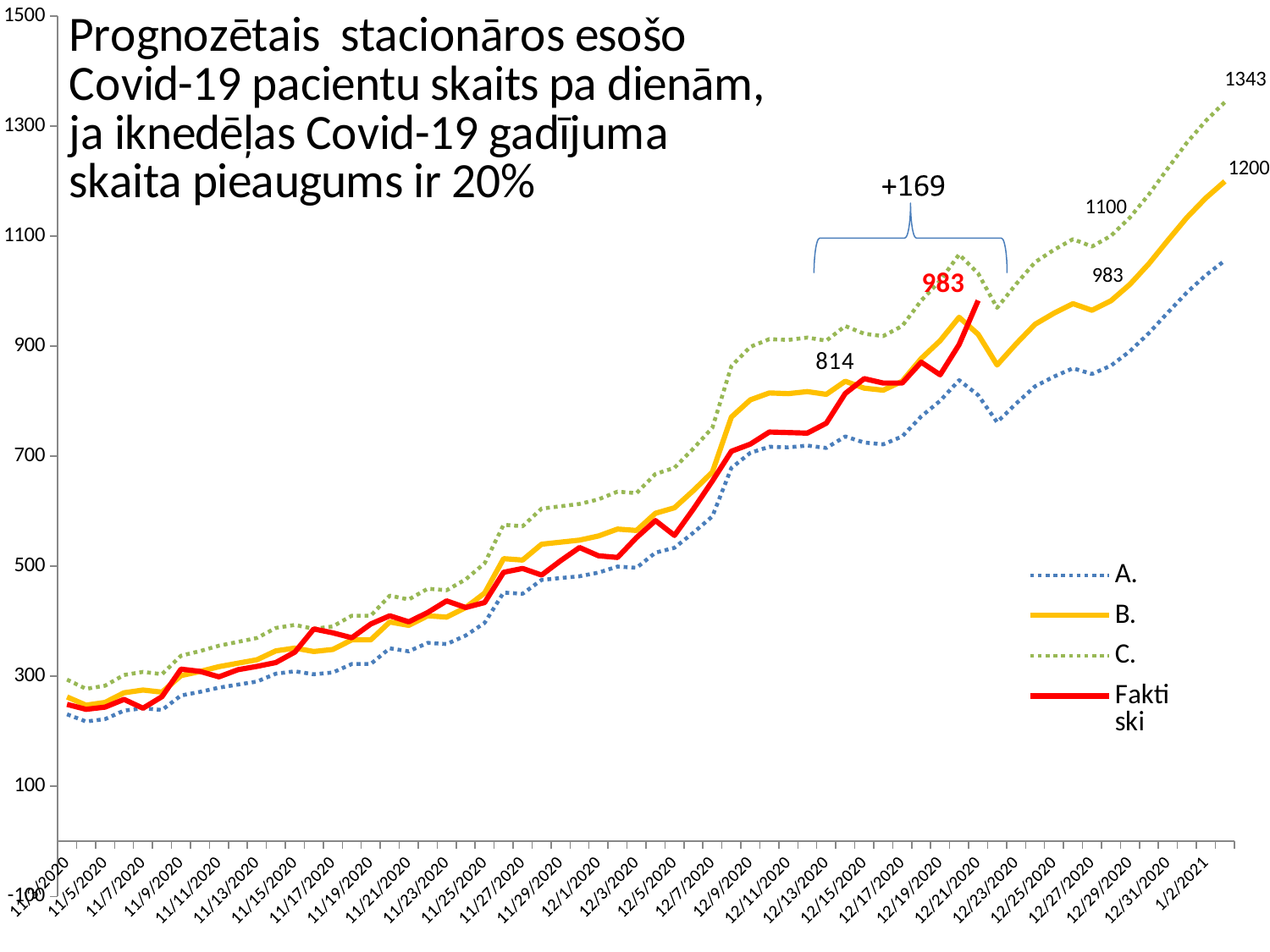
What is the final labelled value of series B. at 1/2/2021? 1200 Is the value of series A. at 1/2/2021 greater or less than 1100? less Which series has the lowest value at 1/2/2021? A. What is the final labelled value of series C. at 1/2/2021? 1343 What increase is shown by the bracket annotation above the lines? +169 What is the difference between the final values of series C. (1343) and series B. (1200)? 143 Do the values of series B. generally rise or fall from 11/3/2020 to 1/2/2021? rise What are the series names listed in the legend? A., B., C., Faktiski How many series does the legend list? 4 What is the last labelled value of the Faktiski series? 983 Which series has the highest value at 1/2/2021? C. What kind of chart is shown on the slide? line chart